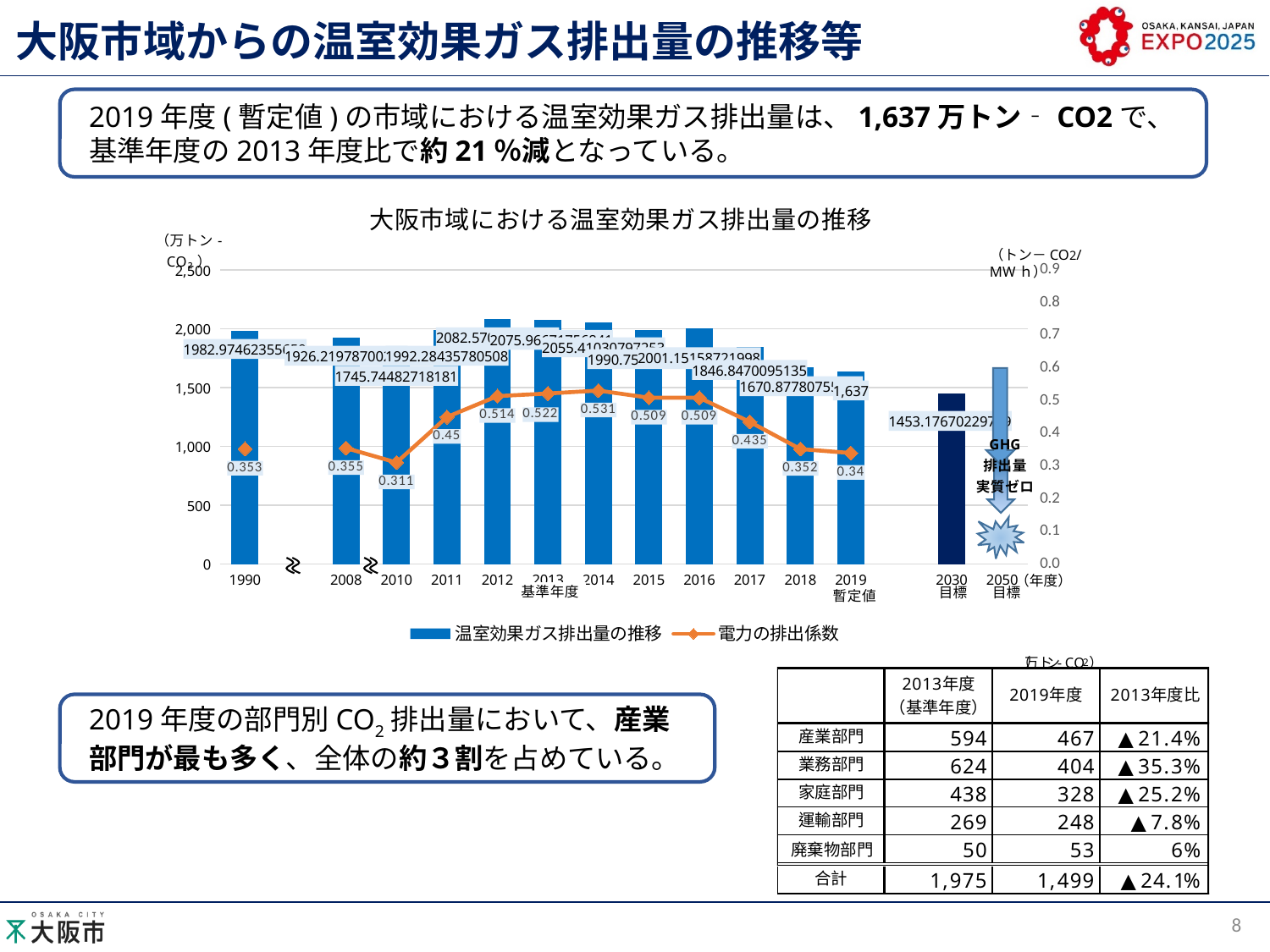
In the chart 大阪市域における温室効果ガス排出量の推移, what is the difference between the 電力の排出係数 values for 2014 and 2010? 0.22 In the chart 大阪市域における温室効果ガス排出量の推移, is the greenhouse gas emission bar for 2012 greater or less than 2,000? greater In the chart 大阪市域における温室効果ガス排出量の推移, which year has the lowest 電力の排出係数 value? 2010 In the chart 大阪市域における温室効果ガス排出量の推移, what is the 電力の排出係数 value for 2010? 0.311 In the chart 大阪市域における温室効果ガス排出量の推移, does the 電力の排出係数 line rise or fall from 2016 to 2019? fall In the chart 大阪市域における温室効果ガス排出量の推移, what is the 電力の排出係数 value for 2014? 0.531 How many series does the legend of the chart 大阪市域における温室効果ガス排出量の推移 list? 2 In the chart 大阪市域における温室効果ガス排出量の推移, is the greenhouse gas emission bar for 2019 (暫定値) greater or less than 2,000? less In the chart 大阪市域における温室効果ガス排出量の推移, which year has the highest 電力の排出係数 value? 2014 In the chart 大阪市域における温室効果ガス排出量の推移, what is the greenhouse gas emission value shown for 2019 (暫定値)? 1,637 In the chart 大阪市域における温室効果ガス排出量の推移, what is the 電力の排出係数 value for 1990? 0.353 In the chart 大阪市域における温室効果ガス排出量の推移, which year has the larger 電力の排出係数 value, 2011 or 2018? 2011